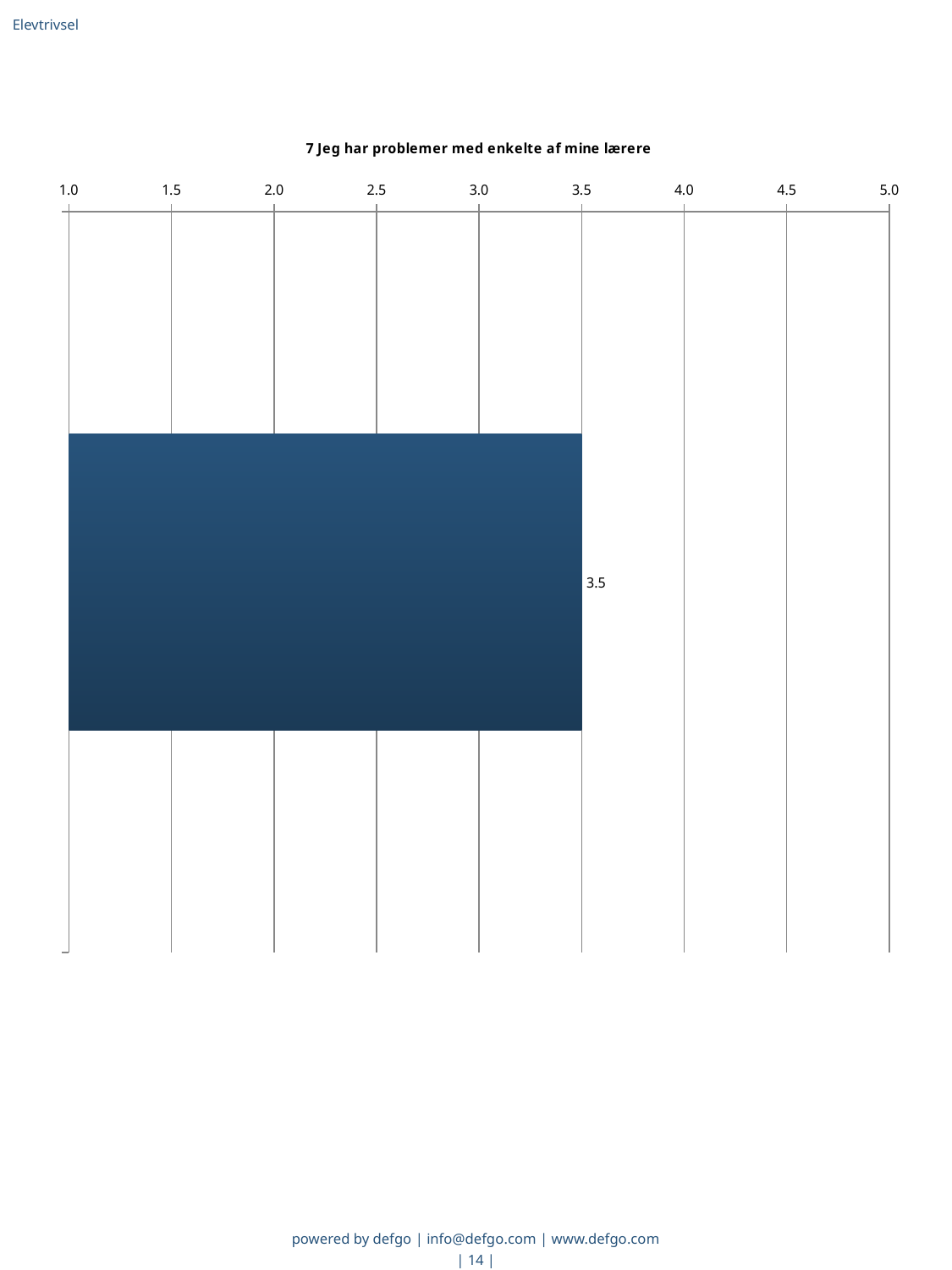
Is the value of the bar greater or less than 4.0? less Is the value of the bar greater or less than 3.0? greater What is the title of the chart? 7 Jeg har problemer med enkelte af mine lærere What is the lowest value shown on the chart's axis? 1.0 What is the value shown by the bar in the chart? 3.5 How many bars are plotted in the chart? 1 What kind of chart is shown on the slide? bar chart What is the highest value shown on the chart's axis? 5.0